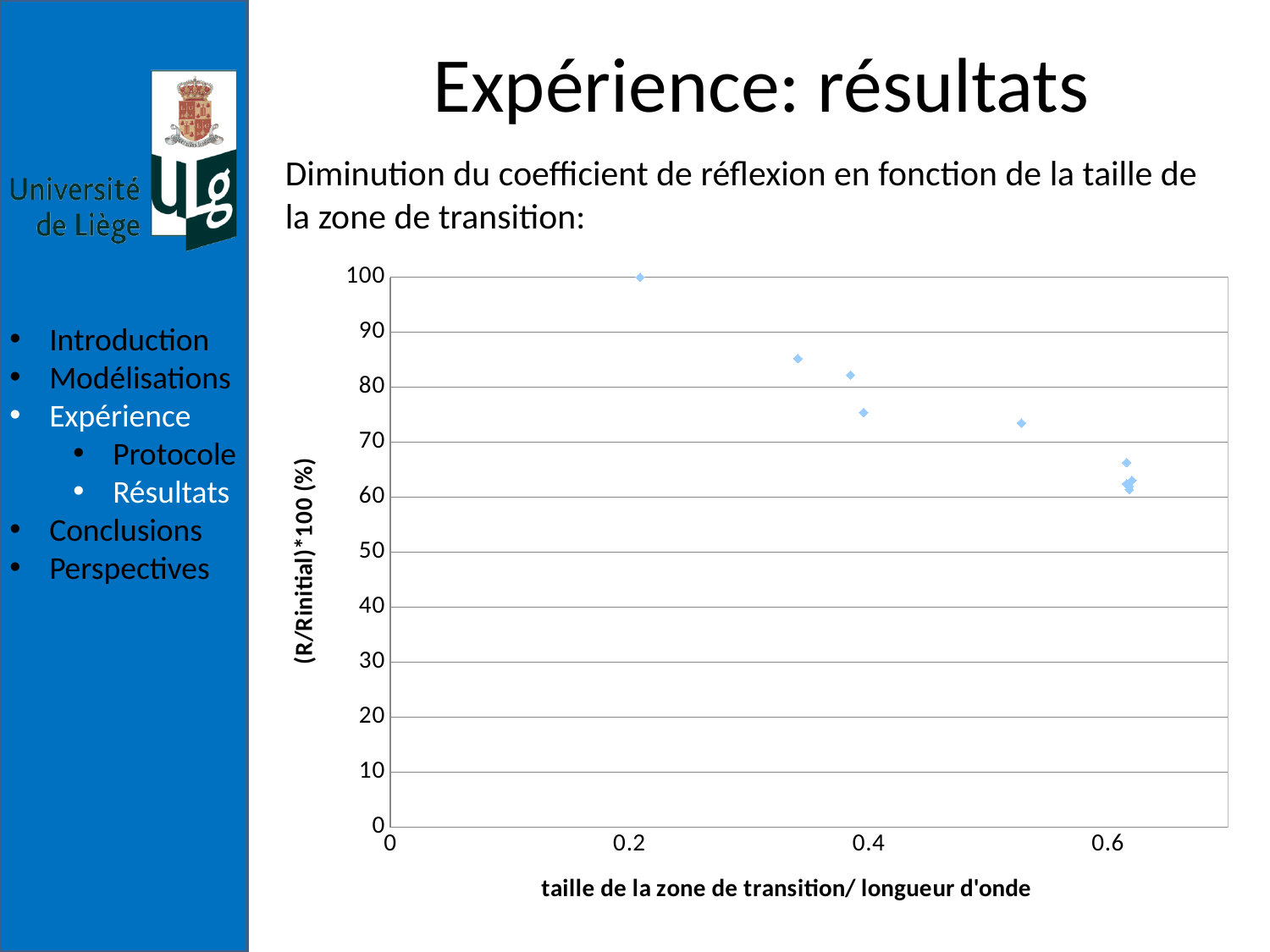
Which has the higher value: the point near x = 0.2 or the point near x = 0.53? the point near x = 0.2 What kind of chart is shown on the slide? scatter chart Is the value of the point plotted near x = 0.2 greater or less than 90? greater Which has the lower value: the point near x = 0.34 or the points near x = 0.6? the points near x = 0.6 Are the values of the points plotted near x = 0.6 greater or less than 50? greater Are the values of the points plotted near x = 0.6 greater or less than 70? less What is the title of the x axis of the chart? taille de la zone de transition/ longueur d'onde What is the title of the y axis of the chart? (R/Rinitial)*100 (%) What is the highest value shown on the y axis of the chart? 100 Do the plotted values rise or fall as the x-axis value (taille de la zone de transition/ longueur d'onde) increases? fall